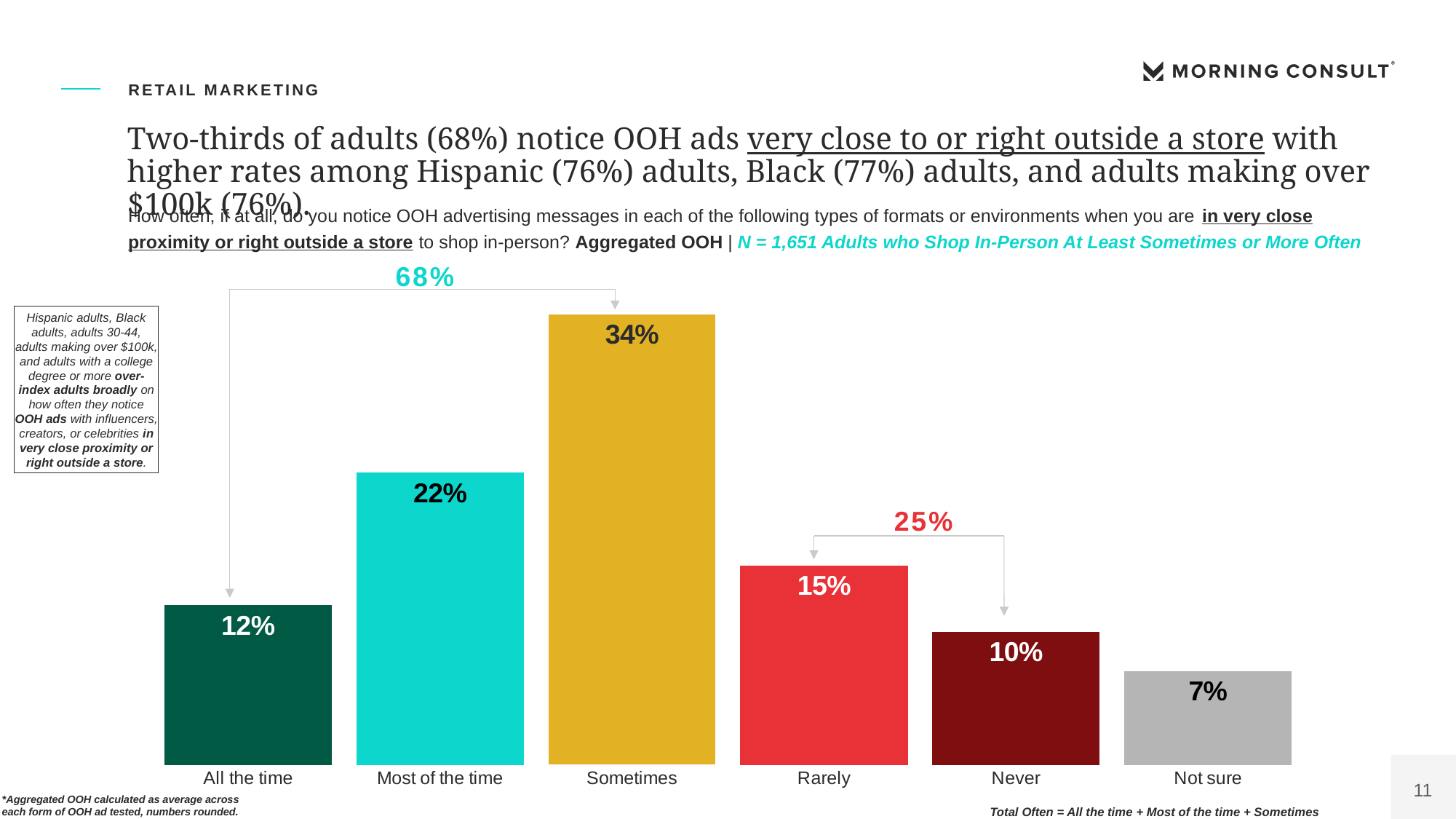
What combined percentage is shown by the bracket spanning 'All the time' through 'Sometimes'? 68% Which category has the highest value in the chart? Sometimes What kind of chart is shown on the slide? Bar chart What is the difference between the 'Sometimes' value and the 'Most of the time' value? 12% What colour is the bar for 'Sometimes'? Yellow What is the value shown for 'All the time'? 12% Which category has the lowest value in the chart? Not sure What combined percentage is shown by the bracket spanning 'Rarely' and 'Never'? 25% Which is larger, the value for 'Rarely' or the value for 'Never'? Rarely What percentage of adults say they notice OOH ads 'Sometimes' when in very close proximity to or right outside a store? 34% How many categories are shown on the x axis of the chart? 6 What is the value shown for 'Not sure'? 7%